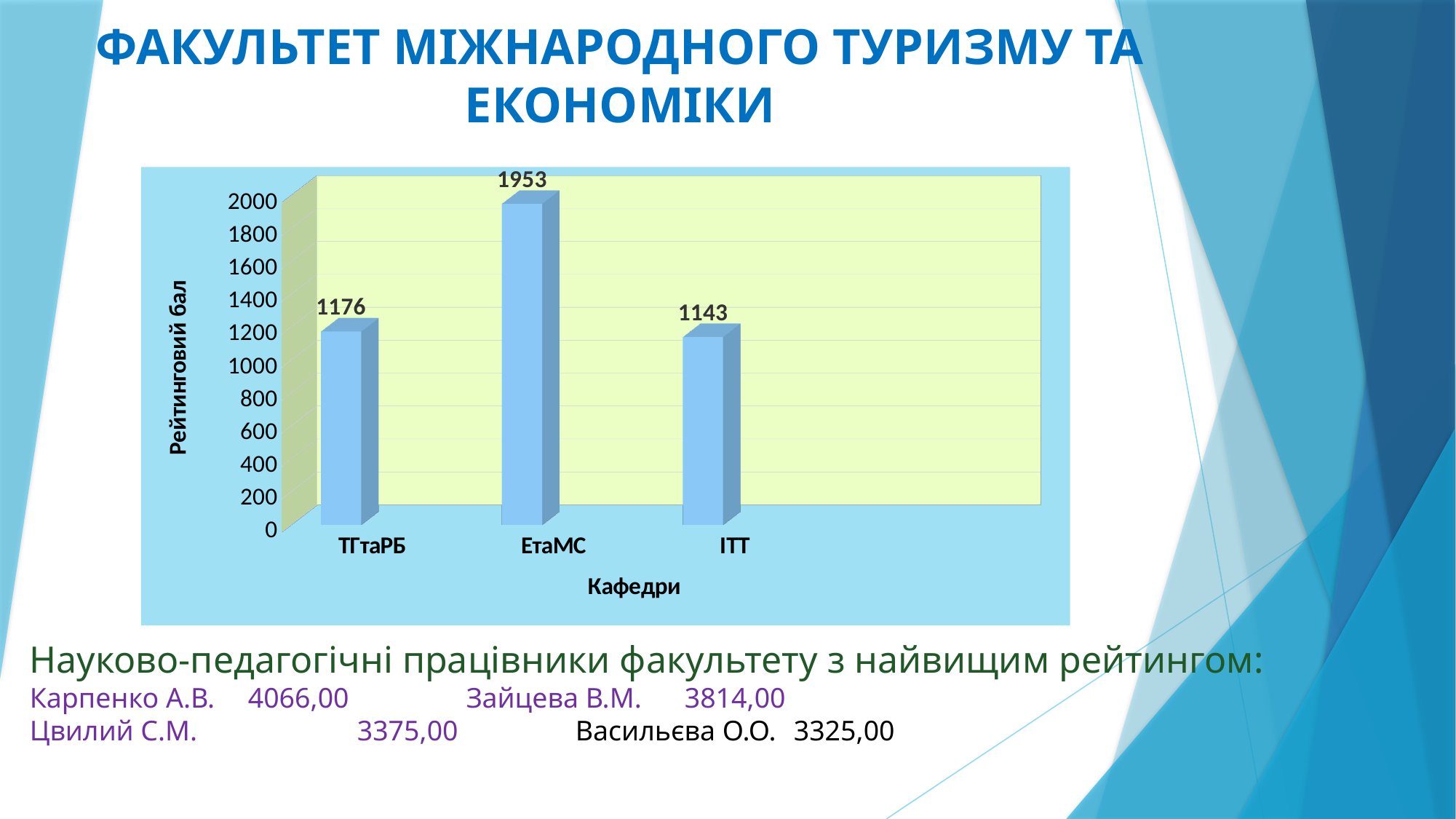
What is the label of the vertical axis of the chart? Рейтинговий бал Which department (кафедра) has the highest rating score? ЕтаМС What is the rating score (Рейтинговий бал) for ТГтаРБ? 1176 What kind of chart is shown on the slide? bar chart Which has a higher rating score, ЕтаМС or ІТТ? ЕтаМС Is the value for ЕтаМС greater or less than 1800? greater What is the difference between the rating scores of ТГтаРБ and ІТТ? 33 What is the rating score for ЕтаМС? 1953 What is the difference between the rating scores of ЕтаМС and ТГтаРБ? 777 How many departments are shown on the chart? 3 Which department has the lowest rating score? ІТТ What is the rating score for ІТТ? 1143